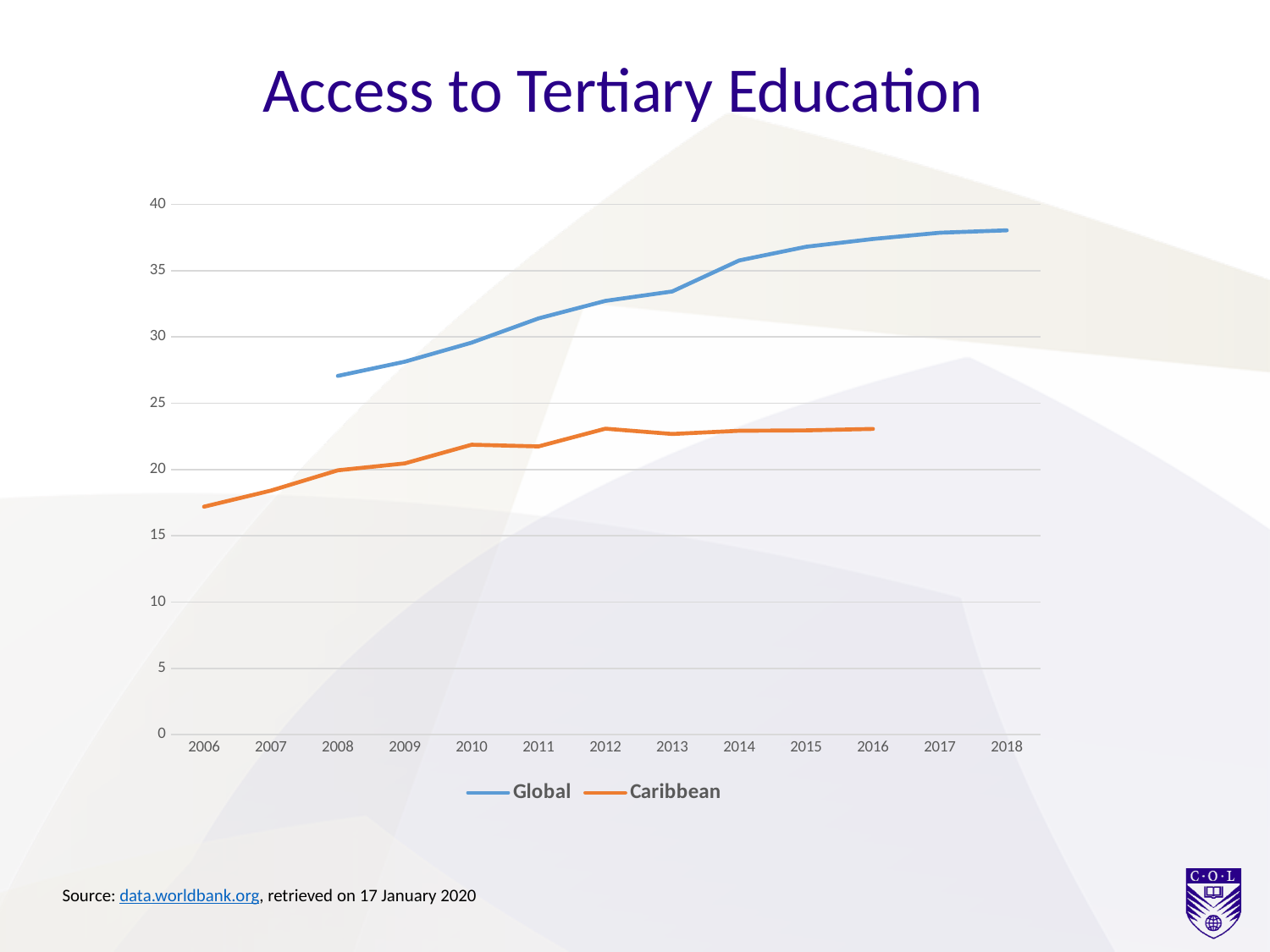
Is the Global value for 2008 greater or less than 25? greater Does the Caribbean line rise or fall from 2006 to 2016? rise Is the Global value for 2018 greater or less than 35? greater Is the Caribbean value for 2016 greater or less than 25? less Does the Global line rise or fall from 2008 to 2018? rise Which colour is used for the Caribbean series? orange What is the title of the chart? Access to Tertiary Education How many series does the legend list? 2 What kind of chart is shown on the slide? line chart Which series has the higher value in 2012, Global or Caribbean? Global How many years are labelled on the x axis? 13